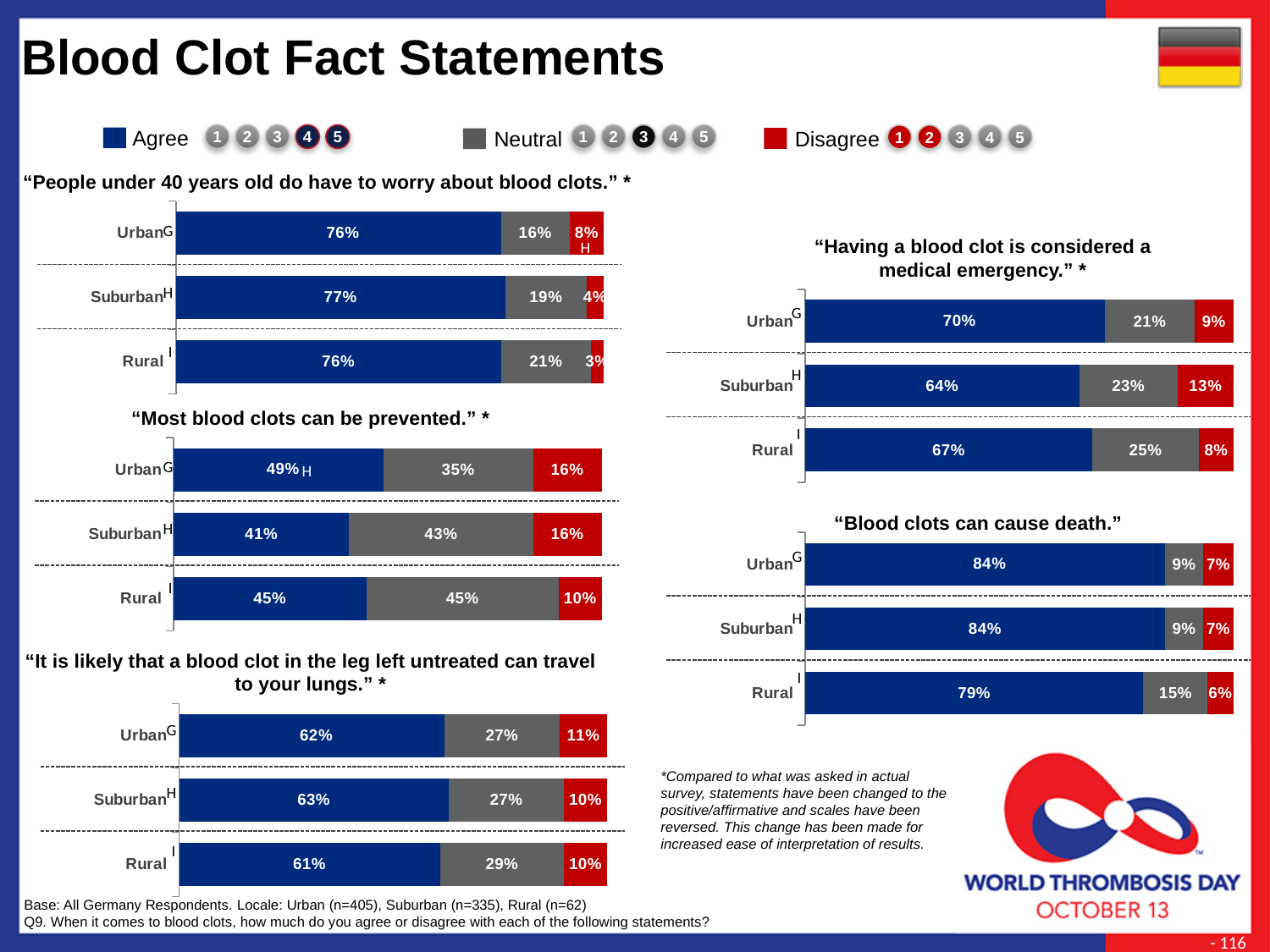
In the chart "Having a blood clot is considered a medical emergency.", what is the difference between the Urban and Suburban Agree percentages? 6% In the chart "Blood clots can cause death.", what is the total of the Agree, Neutral and Disagree percentages for the Rural bar? 100% In the chart "Having a blood clot is considered a medical emergency.", what percentage of Suburban respondents disagree? 13% In the chart "Most blood clots can be prevented.", which locale has the highest Agree percentage? Urban In the chart "It is likely that a blood clot in the leg left untreated can travel to your lungs.", is the Neutral percentage larger for Rural or for Urban? Rural Which colour represents Disagree in the charts? Red What type of chart is used for "Blood clots can cause death."? Stacked bar chart In the chart "Blood clots can cause death.", which locale has the lowest Agree percentage? Rural In the chart "Most blood clots can be prevented.", what percentage of Suburban respondents are neutral? 43% How many series does the legend at the top of the slide list? 3 In the chart "People under 40 years old do have to worry about blood clots.", what percentage of Suburban respondents agree? 77% How many locale categories are shown in the chart "Most blood clots can be prevented."? 3